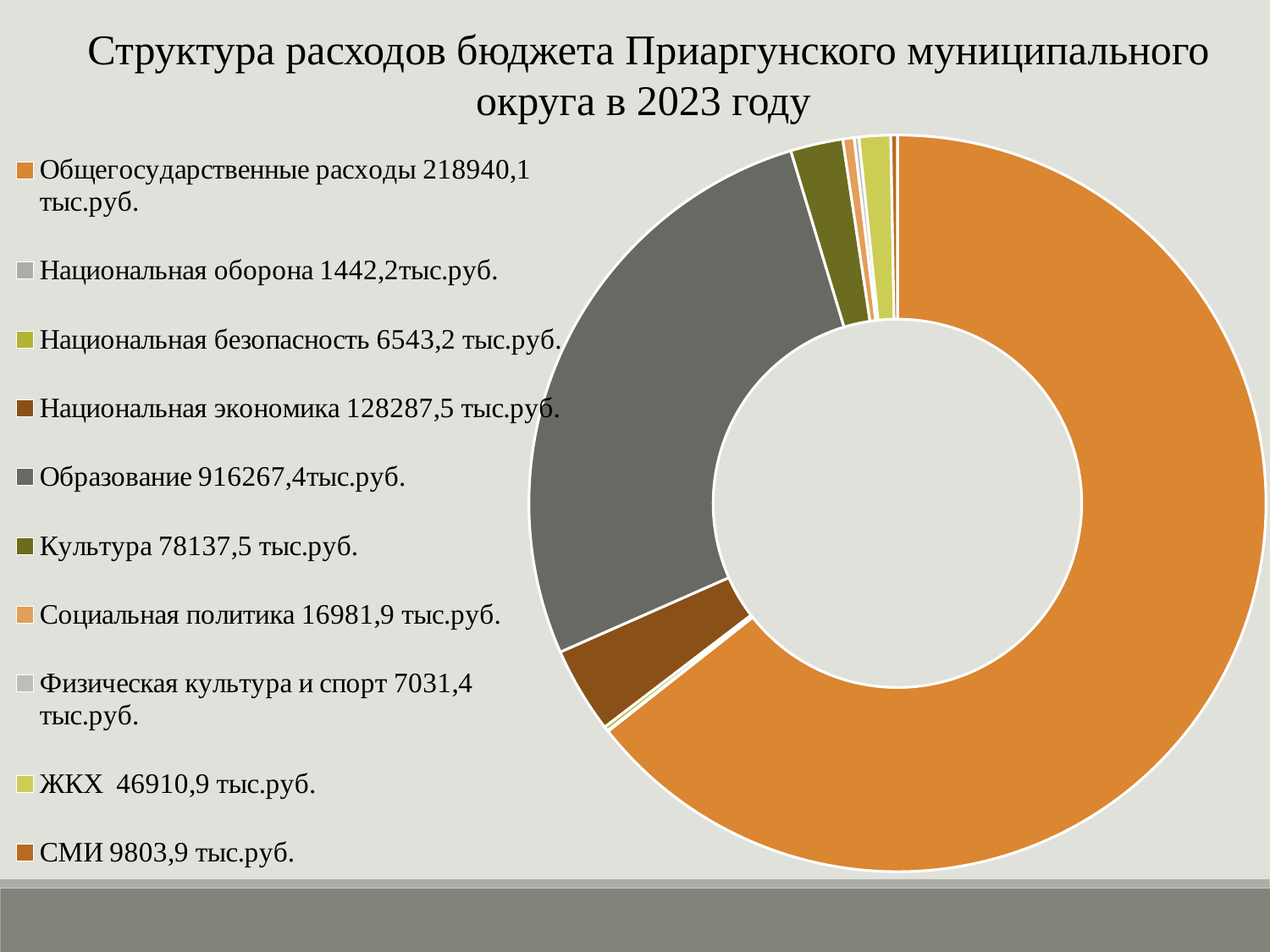
What is the value shown for Социальная политика? 16981,9 тыс.руб. What is the value shown for Национальная оборона? 1442,2 тыс.руб. What is the value shown for Культура? 78137,5 тыс.руб. According to the legend values, what is the difference between Национальная экономика and Культура? 50150,0 тыс.руб. What is the value shown for Образование? 916267,4 тыс.руб. According to the legend values, which is larger: Национальная безопасность or Физическая культура и спорт? Физическая культура и спорт What is the value shown for Общегосударственные расходы? 218940,1 тыс.руб. What is the value shown for СМИ? 9803,9 тыс.руб. What kind of chart is shown on the slide? Doughnut (pie) chart What is the title of the chart? Структура расходов бюджета Приаргунского муниципального округа в 2023 году What is the value shown for ЖКХ? 46910,9 тыс.руб. How many expenditure categories does the legend list? 10